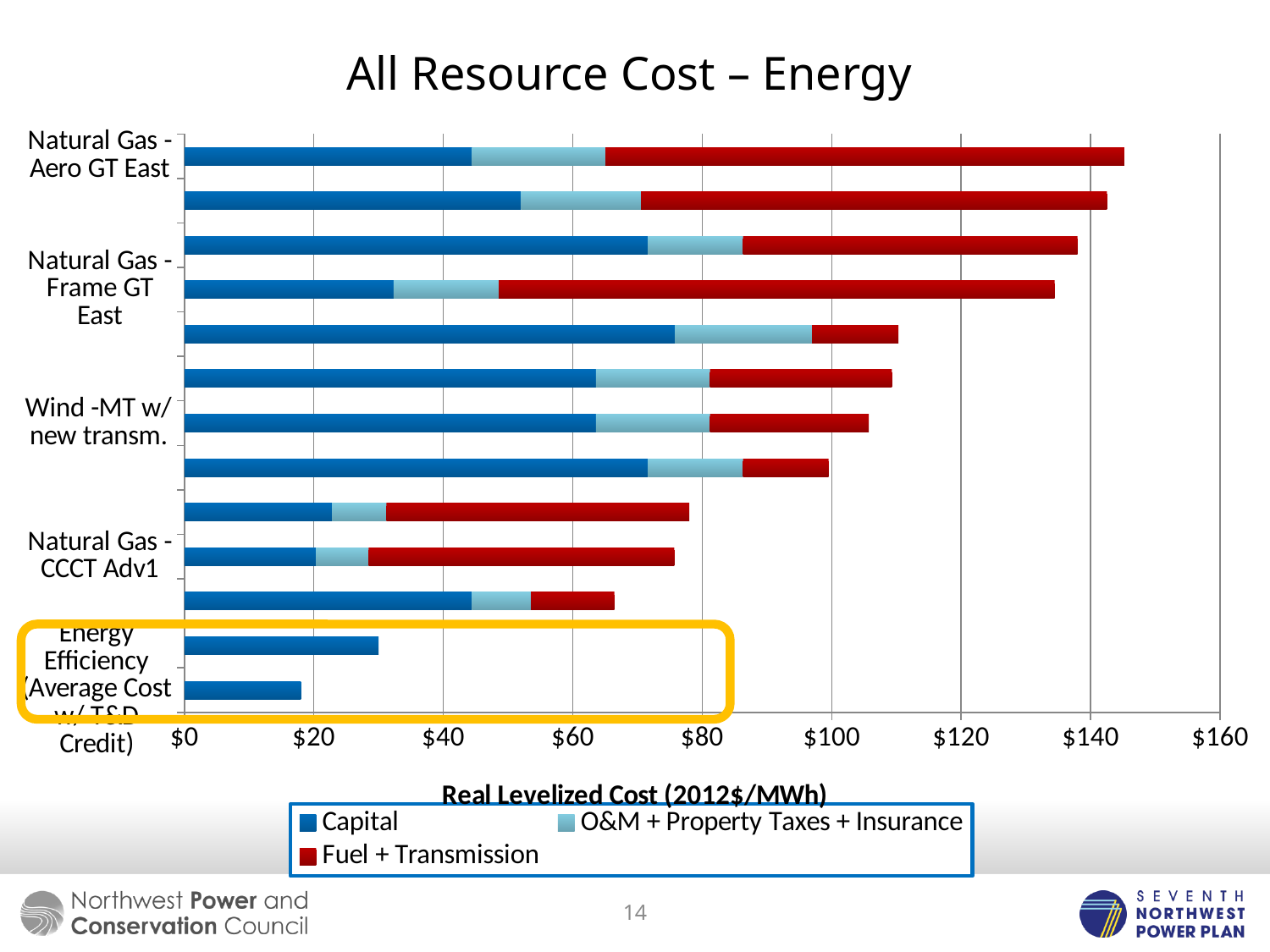
Which has the higher total cost, Natural Gas - Aero GT East or Natural Gas - CCCT Adv1? Natural Gas - Aero GT East How many bars are plotted in the chart? 13 Is the total cost for Natural Gas - Aero GT East greater or less than $140? greater Which labeled resource has the lowest total cost? Energy Efficiency (Average Cost w/ T&D Credit) Is the total cost for Natural Gas - Frame GT East greater or less than $140? less Is the total cost for Wind -MT w/ new transm. greater or less than $100? greater What kind of chart is shown on the slide? Stacked bar chart What is the label of the horizontal axis? Real Levelized Cost (2012$/MWh) What is the title of the chart? All Resource Cost – Energy How many series does the legend list? 3